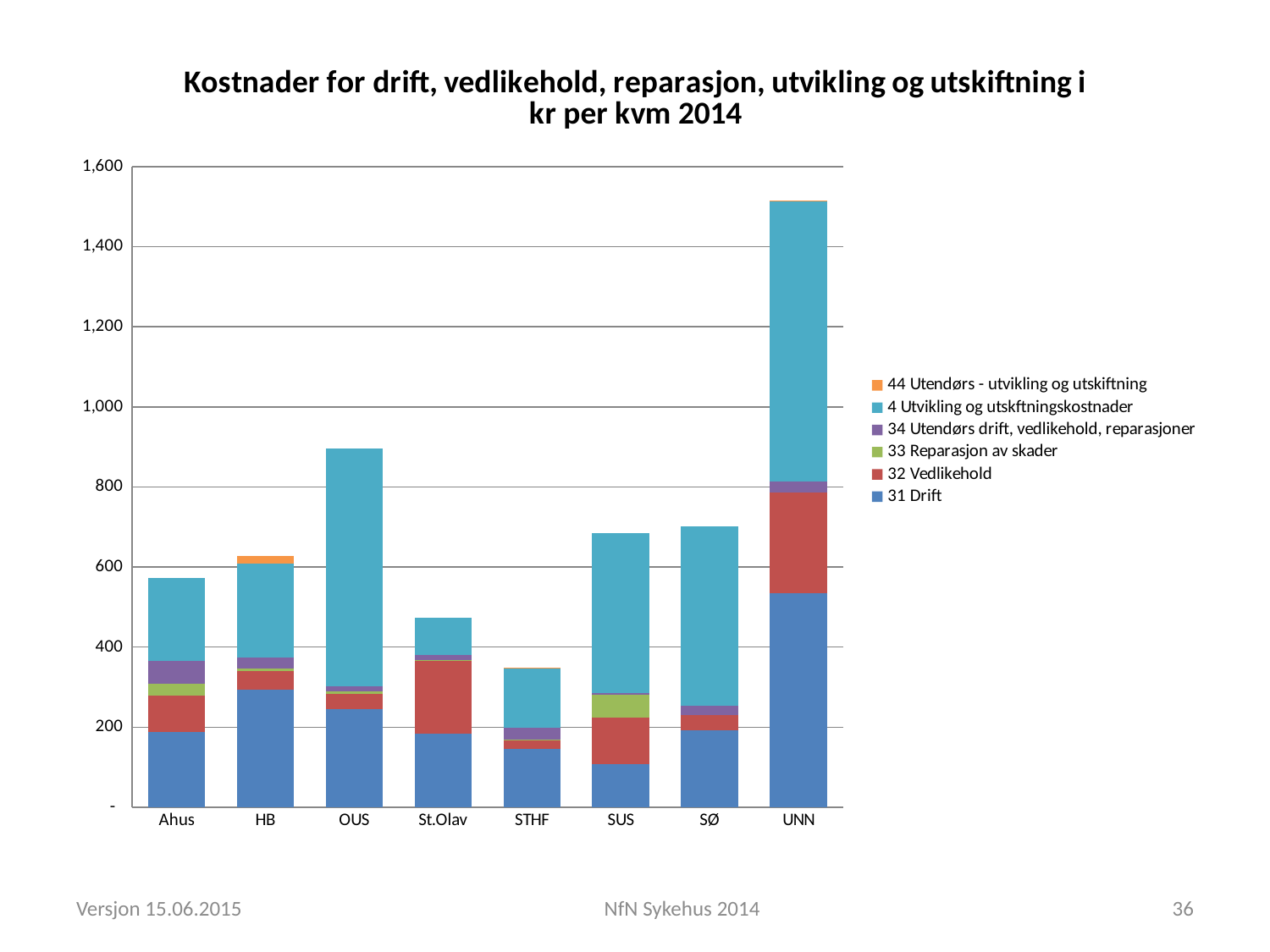
How many series does the legend list? 6 Is the total value for STHF greater or less than 400? less Which hospital has the highest total cost per kvm? UNN Is the total value for OUS greater or less than 800? greater Which hospital has the larger '31 Drift' segment, HB or Ahus? HB Which has the larger total cost per kvm, OUS or SUS? OUS What kind of chart is shown on the slide? Stacked bar chart Is the total value for St.Olav greater or less than 600? less Which hospital is the only one with a visible '44 Utendørs - utvikling og utskiftning' (orange) segment? HB Which hospital has the lowest total cost per kvm? STHF How many hospitals (categories) are shown on the x axis? 8